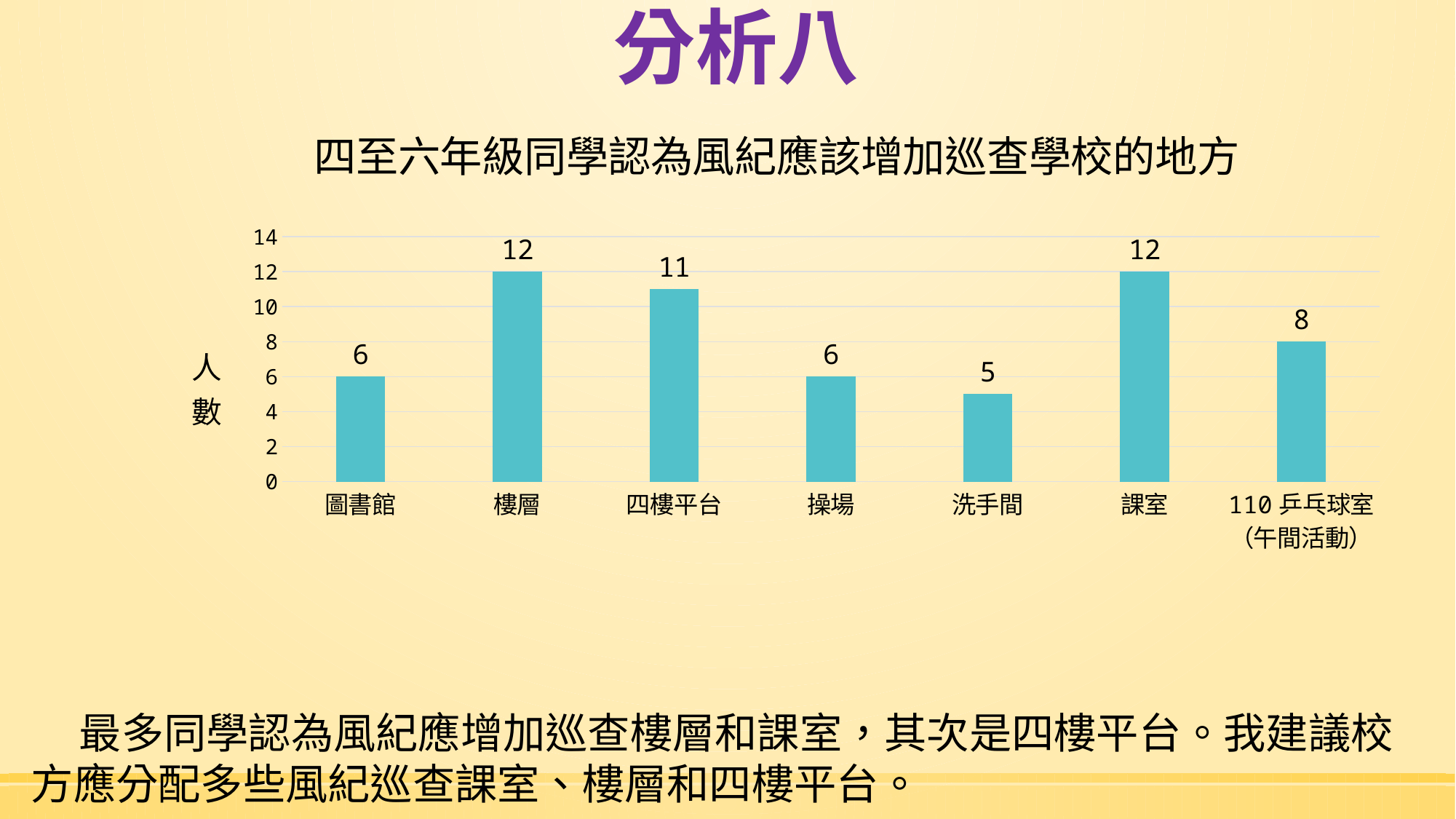
What is the difference between the values for 課室 and 操場? 6 What is the value for 四樓平台? 11 How many categories are shown on the x axis? 7 Is the value for 樓層 greater or less than 10? greater What is the title of the chart? 四至六年級同學認為風紀應該增加巡查學校的地方 Which categories share the highest value? 樓層 and 課室 What kind of chart is shown? bar chart Which is larger, the value for 四樓平台 or the value for 110 乒乓球室（午間活動）? 四樓平台 What is the value for 110 乒乓球室（午間活動）? 8 What is the value for 圖書館? 6 What is the value for 洗手間? 5 Which category has the lowest value? 洗手間